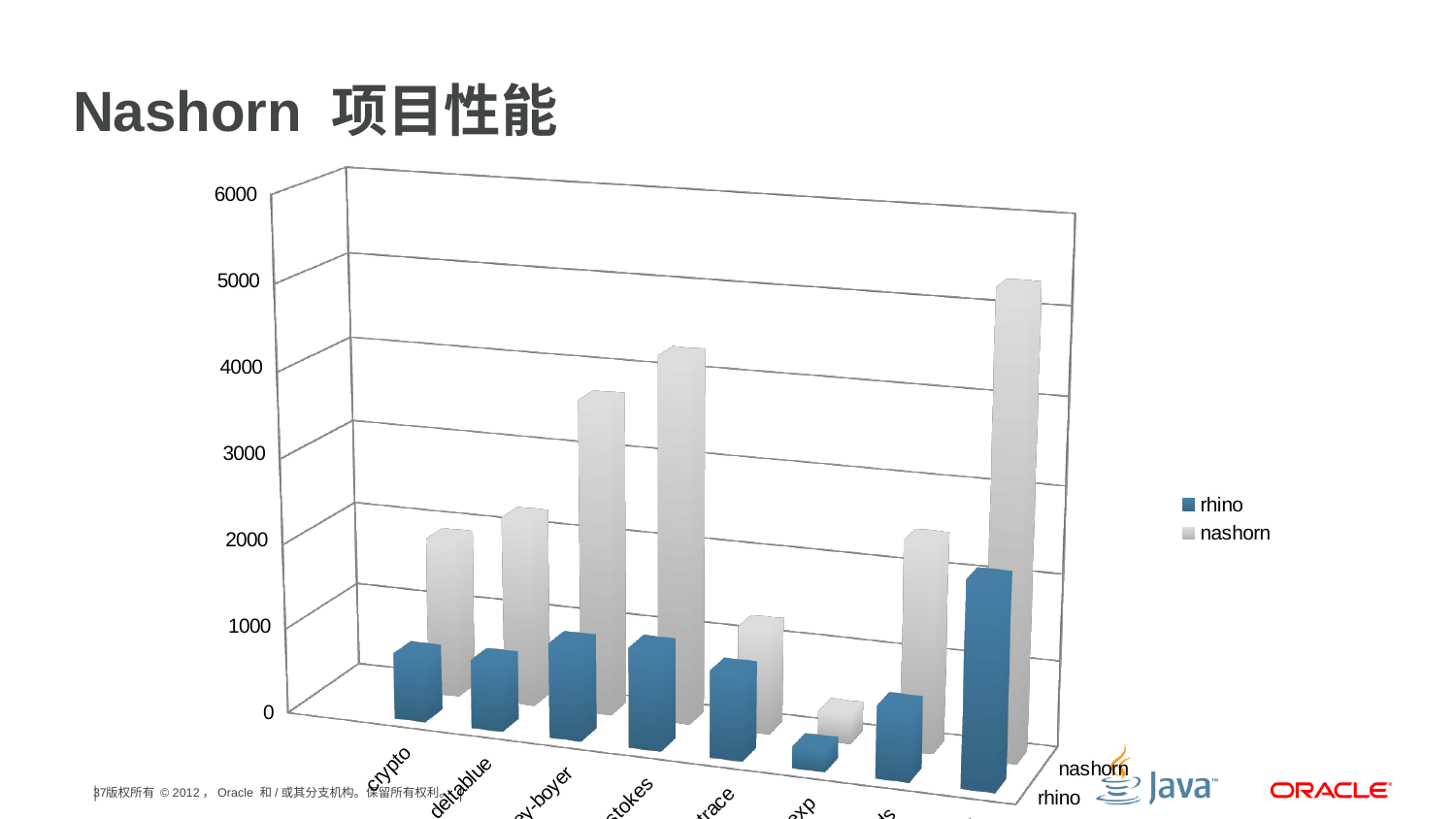
Is the nashorn value for crypto greater or less than 1000? greater For the crypto category, which series has the larger value, rhino or nashorn? nashorn What kind of chart is shown on the slide? bar chart Is the rhino value for crypto greater or less than 2000? less Is the nashorn value for deltablue greater or less than 1000? greater What are the two series named in the legend? rhino and nashorn For the deltablue category, which series has the larger value, rhino or nashorn? nashorn What is the highest value shown on the vertical axis? 6000 How many categories (groups of bars) are plotted on the chart? 8 How many series does the legend list? 2